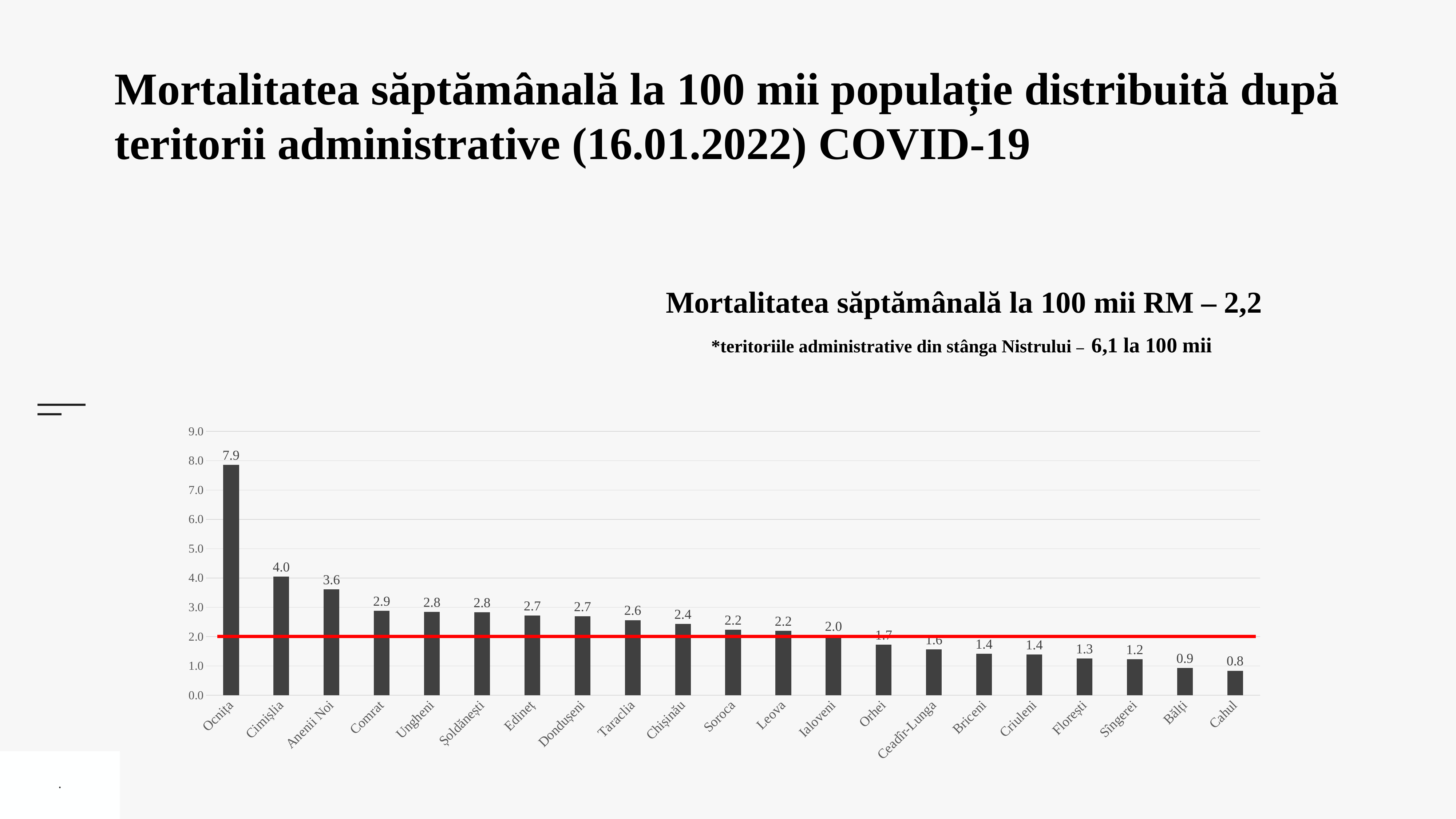
Which territory has the lowest weekly mortality per 100 thousand? Cahul Do the values rise or fall from left to right along the x axis? fall What is the weekly mortality per 100 thousand for Ocnița? 7.9 Is the value for Orhei greater or less than 2.0? less What is the value shown for Chișinău? 2.4 Which territory has the highest weekly mortality per 100 thousand? Ocnița What is the difference between the values for Ocnița and Cimișlia? 3.9 How many administrative territories are shown on the chart? 21 Which has a higher value, Anenii Noi or Comrat? Anenii Noi What kind of chart is shown on the slide? bar chart What is the value shown for Cahul? 0.8 At what value is the horizontal red line drawn on the chart? 2.0